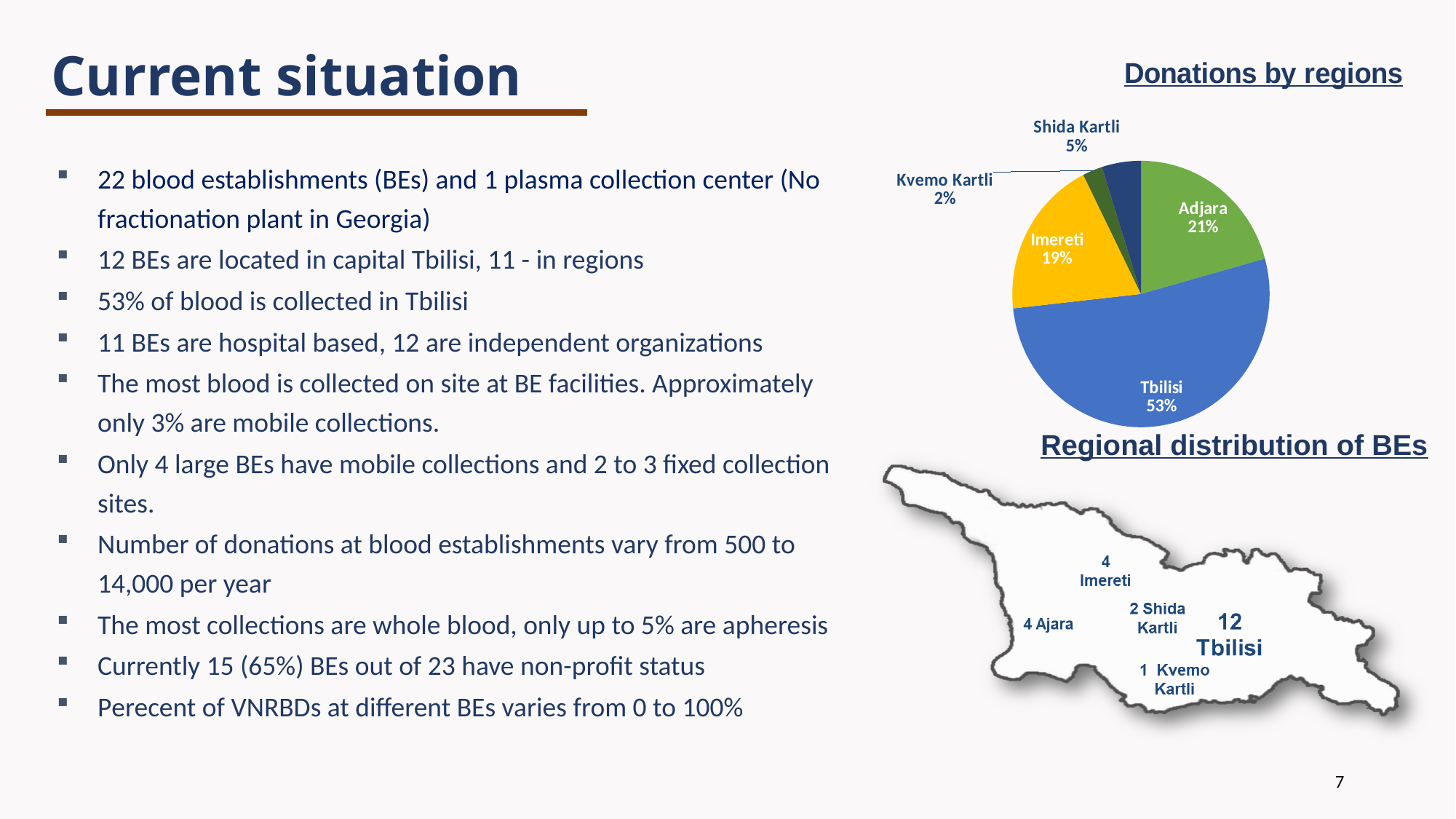
What type of chart is 'Donations by regions'? Pie chart In the 'Donations by regions' pie chart, which region has the largest share of donations? Tbilisi In the 'Donations by regions' pie chart, which has a larger share: Adjara or Imereti? Adjara In the 'Donations by regions' pie chart, what is the difference in percentage points between Tbilisi and Adjara? 32 In the 'Donations by regions' pie chart, what percentage is shown for Imereti? 19% In the 'Donations by regions' pie chart, what is the difference in percentage points between Shida Kartli and Kvemo Kartli? 3 In the 'Donations by regions' pie chart, which region has the smallest share of donations? Kvemo Kartli How many regions (slices) are shown in the 'Donations by regions' pie chart? 5 In the 'Donations by regions' pie chart, what percentage is shown for Adjara? 21% In the 'Donations by regions' pie chart, what percentage is shown for Kvemo Kartli? 2% In the 'Donations by regions' pie chart, what share of donations comes from Tbilisi? 53% In the 'Donations by regions' pie chart, what colour is the Imereti slice? Yellow